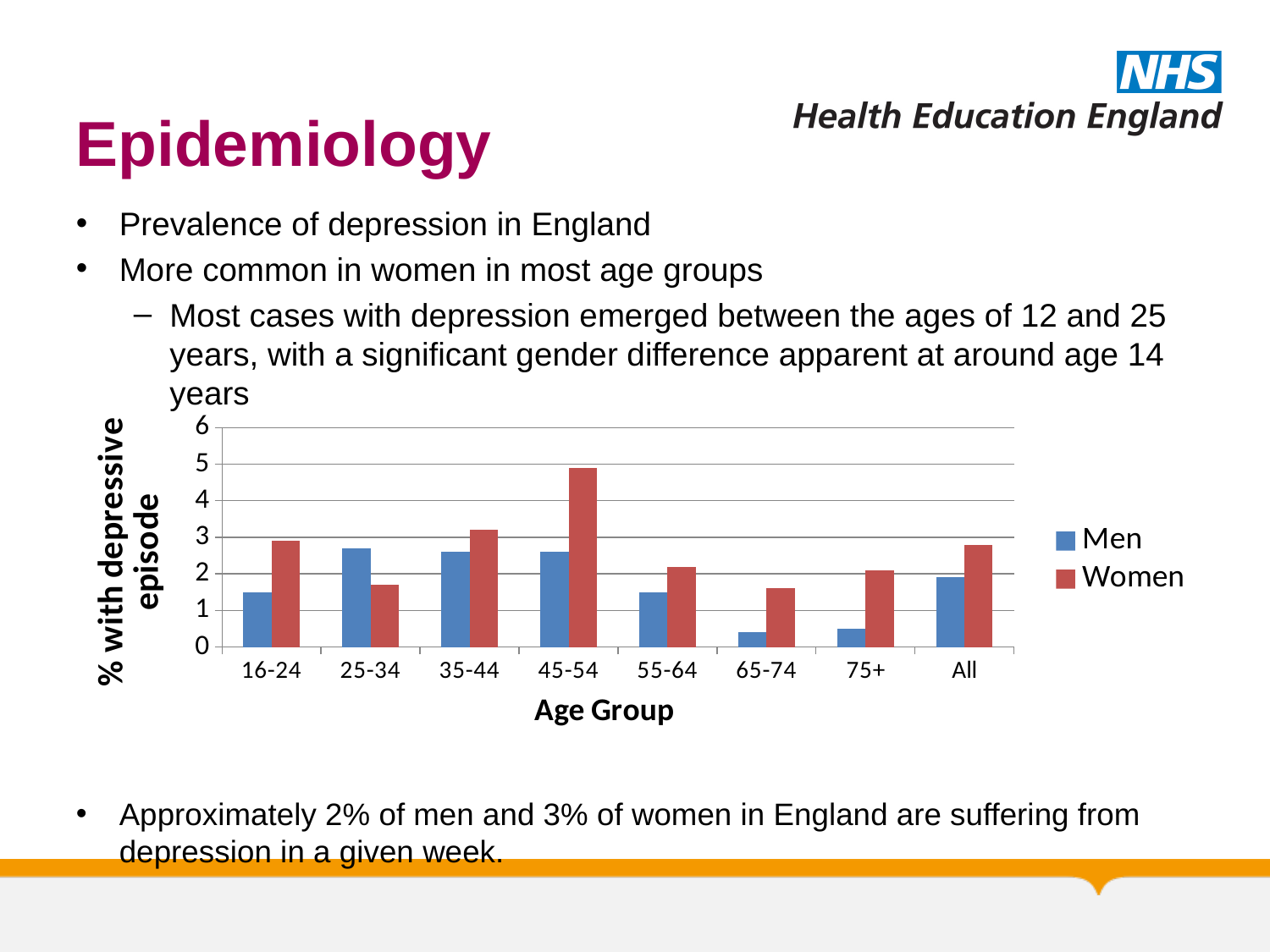
Is the value for Women in the 16-24 age group greater or less than 2? greater Is the value for Women in the 45-54 age group greater or less than 4? greater What is the title of the x axis of the chart? Age Group In the 25-34 age group, which series has the larger value, Men or Women? Men How many age group categories are shown on the x axis of the chart? 8 Which age group has the highest value for Women? 45-54 Is the value for Men in the 65-74 age group greater or less than 1? less In the 75+ age group, which series has the larger value, Men or Women? Women What kind of chart is shown on the slide? bar chart How many series does the chart's legend list? 2